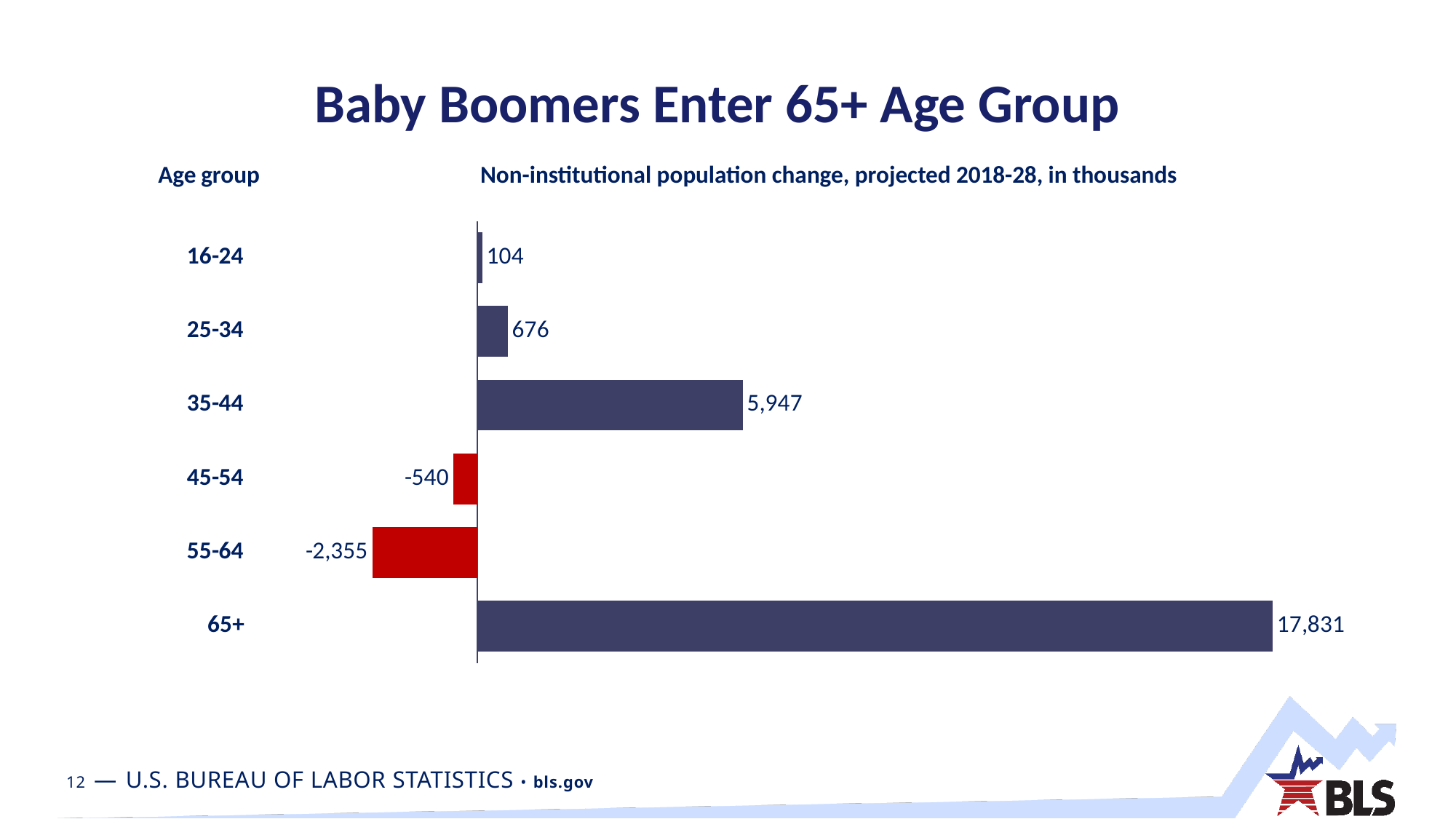
How many age groups show a negative projected population change? 2 Which age group has a larger projected population change, 25-34 or 45-54? 25-34 How many age groups are shown in the chart? 6 What is the projected population change for the 55-64 age group? -2,355 What colour are the bars for age groups with a negative population change? Red What is the projected population change for the 35-44 age group? 5,947 Which age group has the lowest projected population change? 55-64 What kind of chart is shown on the slide? Bar chart What is the projected population change for the 16-24 age group? 104 What is the difference between the projected population change for 35-44 and for 25-34? 5,271 What is the projected non-institutional population change for the 65+ age group? 17,831 Which age group has the largest projected population change? 65+